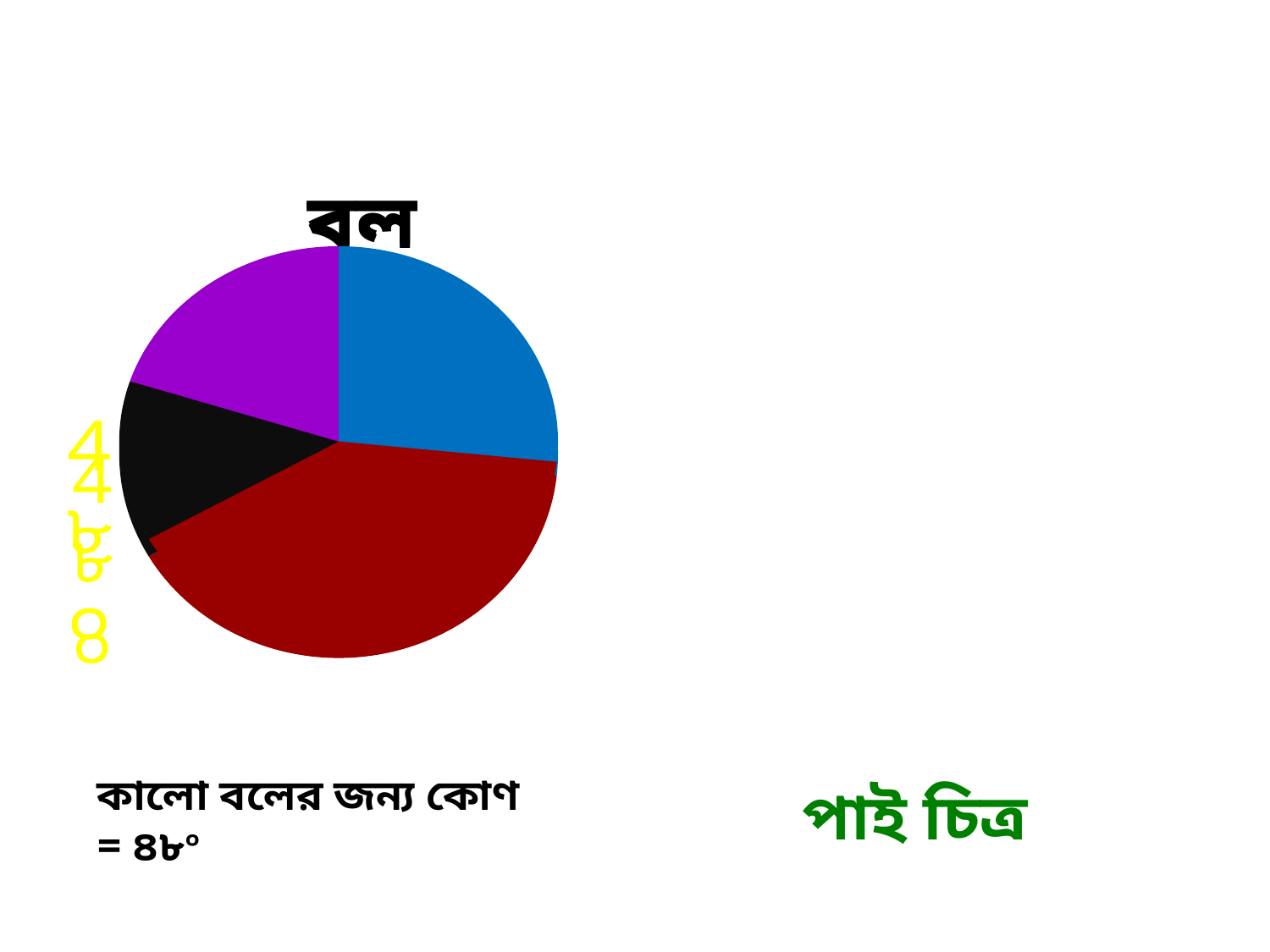
Is the blue slice or the purple slice larger in the pie chart? the blue slice Which slice of the pie chart is the largest? the dark red slice What colour is the largest slice of the pie chart? dark red What is the title of the pie chart? বল What angle is given on the slide for the black ball slice? ৪৮° How many slices does the pie chart have? 4 Which slice of the pie chart is the smallest? the black slice What kind of chart is shown on the slide? pie chart Is the dark red slice or the black slice larger in the pie chart? the dark red slice